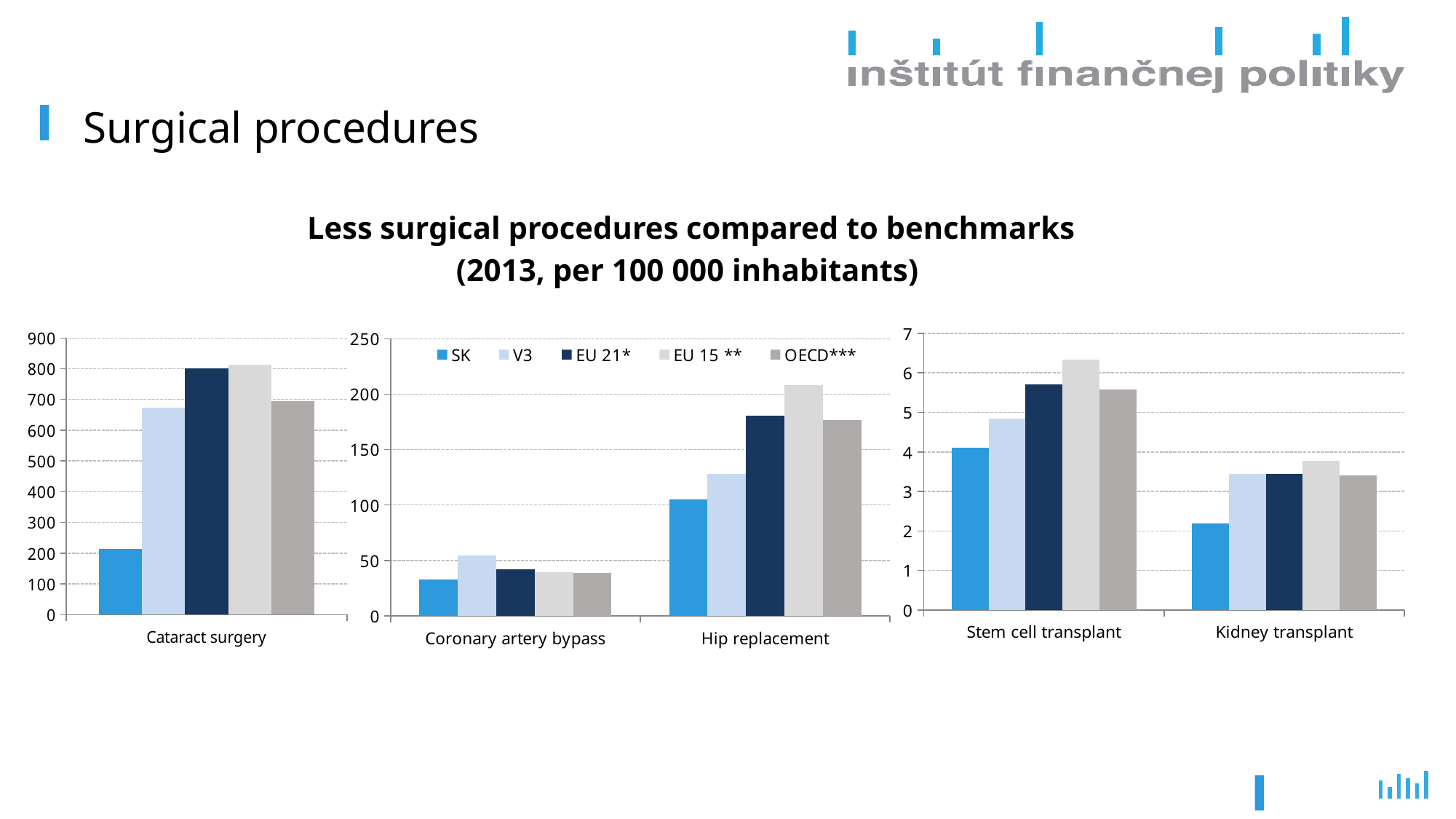
In the left chart (Cataract surgery), which series has the lowest value? SK In the middle chart, which series has the highest value for Coronary artery bypass? V3 How many series does the legend list? 5 In the right chart, which series has the highest value for Stem cell transplant? EU 15 ** In the left chart (Cataract surgery), is the value for SK greater or less than 300? less What kind of chart is used on this slide to show the surgical procedure rates? bar chart How many procedure categories are shown across the three charts on the slide? 5 In the right chart, is the value for SK for Kidney transplant greater or less than 3? less In the middle chart, which series has the highest value for Hip replacement? EU 15 ** In the middle chart, is the value for EU 15 ** for Hip replacement greater or less than 200? greater In the middle chart, which is larger: the SK value for Hip replacement or the SK value for Coronary artery bypass? Hip replacement